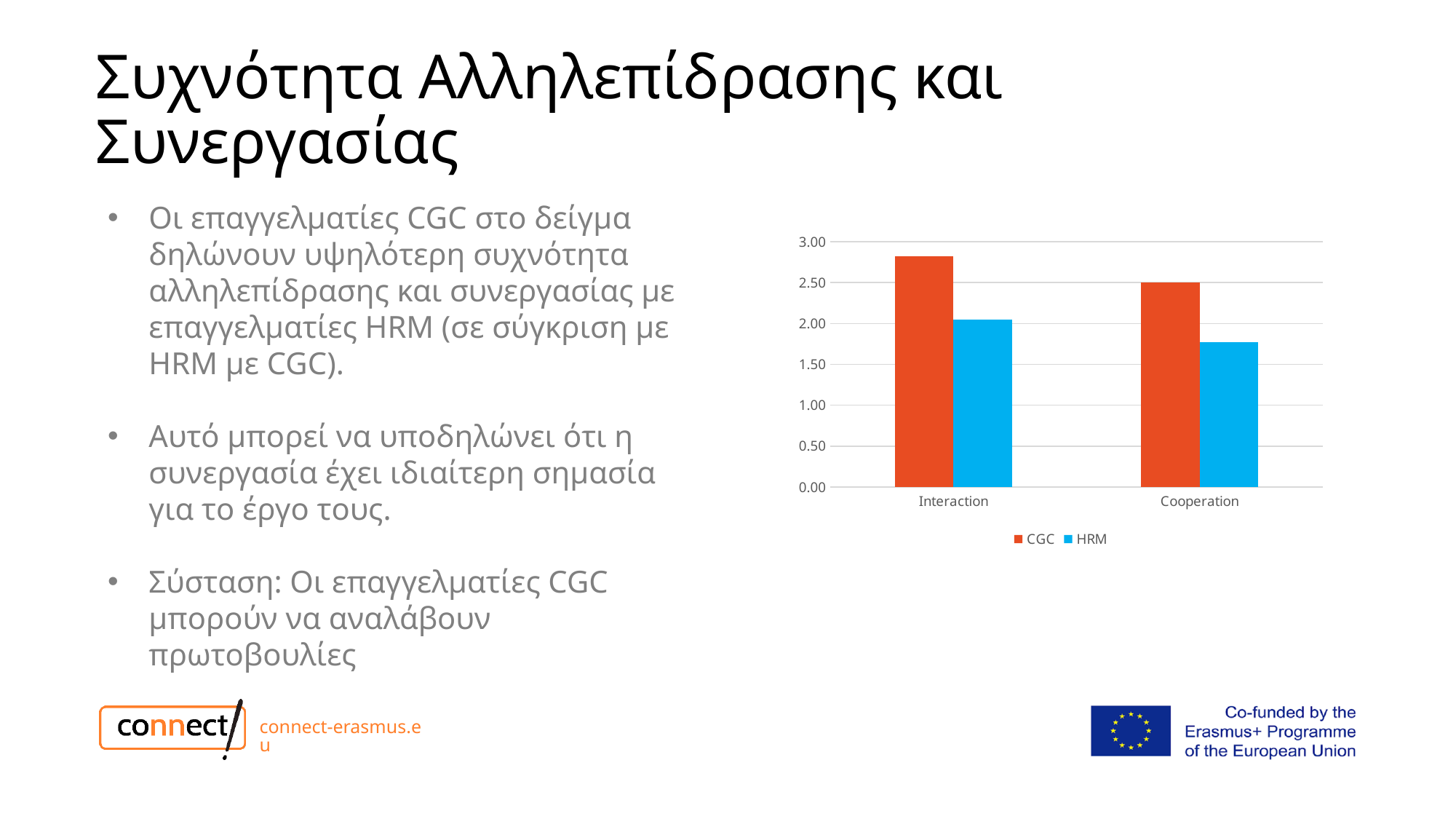
Which bar in the chart is the tallest? CGC for Interaction Is the HRM value for Cooperation greater or less than 2.00? less How many series does the chart legend list? 2 Which bar in the chart is the shortest? HRM for Cooperation Is the CGC value for Interaction greater or less than 2.50? greater Which series has the higher value for Interaction, CGC or HRM? CGC What colour are the HRM bars in the chart? blue How many categories are shown on the x axis of the chart? 2 Is the CGC value for Cooperation greater or less than 2.00? greater Does the CGC value rise or fall from Interaction to Cooperation? fall Which series has the higher value for Cooperation, CGC or HRM? CGC What kind of chart is shown on the slide? bar chart